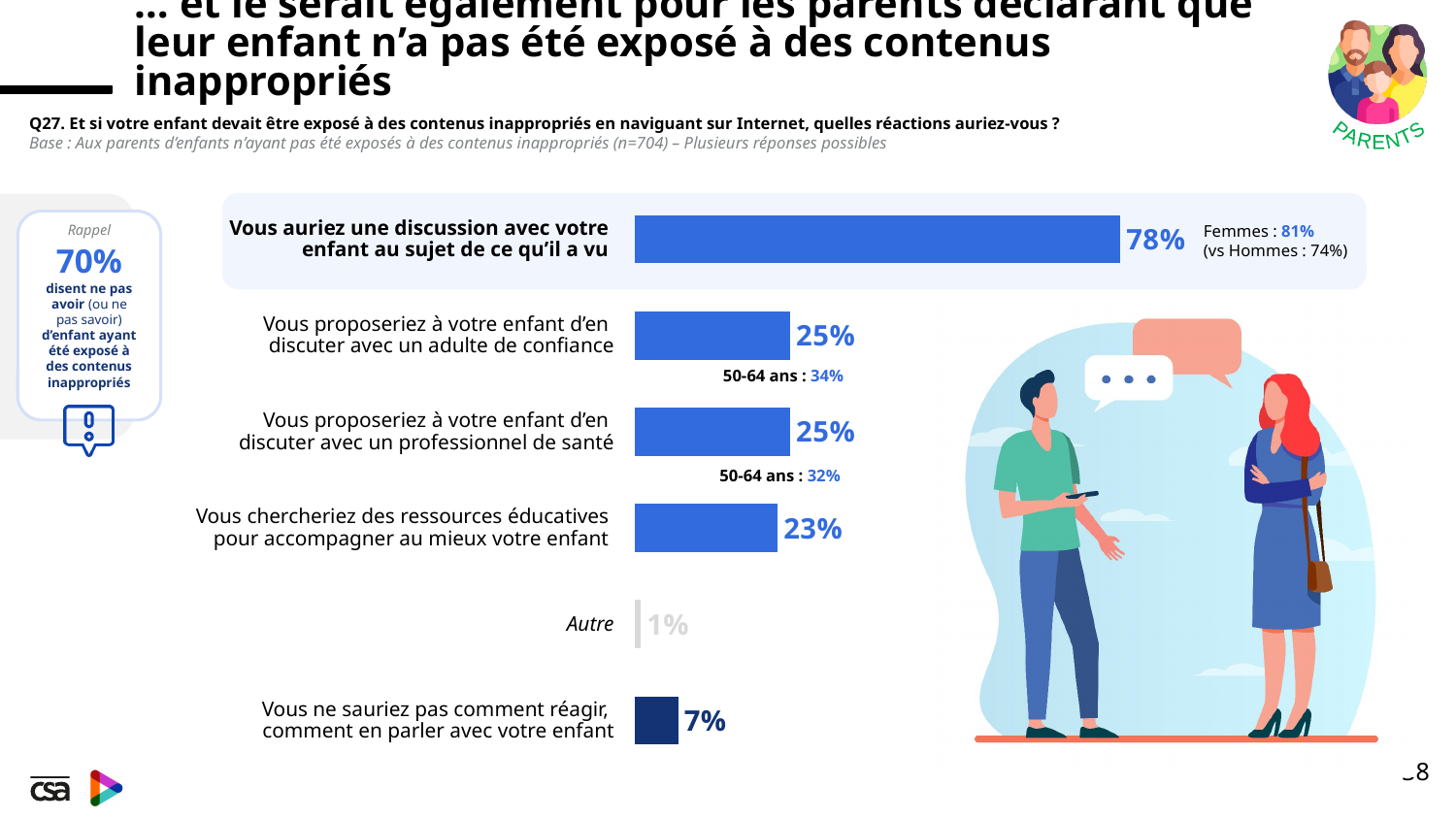
What is the difference between the percentage for having a discussion with the child (78%) and the percentage for seeking educational resources (23%)? 55 percentage points What is the value for the 50-64 ans group for "Vous proposeriez à votre enfant d'en discuter avec un professionnel de santé"? 32% What percentage of women (Femmes) say they would have a discussion with their child about what they saw? 81% What type of chart is shown on the slide? Bar chart What is the value for "Autre"? 1% What is the value for "Vous chercheriez des ressources éducatives pour accompagner au mieux votre enfant"? 23% How many response categories are shown in the chart? 6 Which is larger: the value for "Vous chercheriez des ressources éducatives" or the value for "Vous ne sauriez pas comment réagir"? Vous chercheriez des ressources éducatives What percentage of parents say they would have a discussion with their child about what they saw ("Vous auriez une discussion avec votre enfant au sujet de ce qu'il a vu")? 78% Which response has the highest percentage? Vous auriez une discussion avec votre enfant au sujet de ce qu'il a vu What is the value for "Vous ne sauriez pas comment réagir, comment en parler avec votre enfant"? 7% Which response has the lowest percentage? Autre